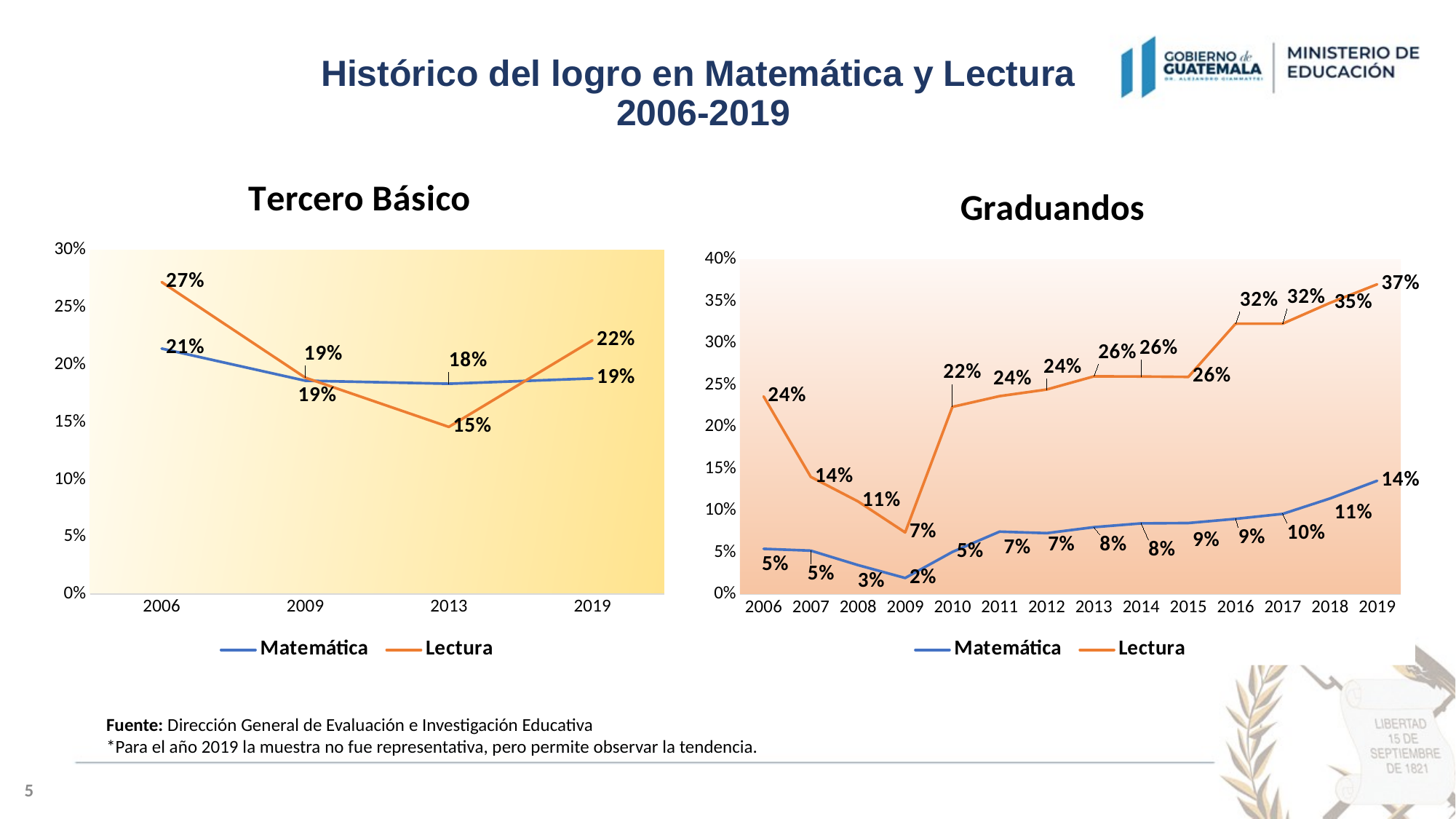
In the Graduandos chart, what is the Lectura value for 2019? 37% In the Graduandos chart, what is the Matemática value for 2009? 2% In the Graduandos chart, what is the difference between the Lectura values for 2009 and 2010? 15% In the Tercero Básico chart, what is the Lectura value for 2006? 27% In the Graduandos chart, how many series does the legend list? 2 In the Graduandos chart, which is larger in 2010: the Lectura value or the Matemática value? Lectura In the Tercero Básico chart, which year has the lowest Lectura value? 2013 In the Graduandos chart, which year has the highest Lectura value? 2019 In the Tercero Básico chart, what is the Matemática value for 2013? 18% In the Tercero Básico chart, how many years are plotted on the x axis? 4 What kind of chart is the Graduandos chart? Line chart In the Tercero Básico chart, what is the difference between the Lectura and Matemática values in 2006? 6%